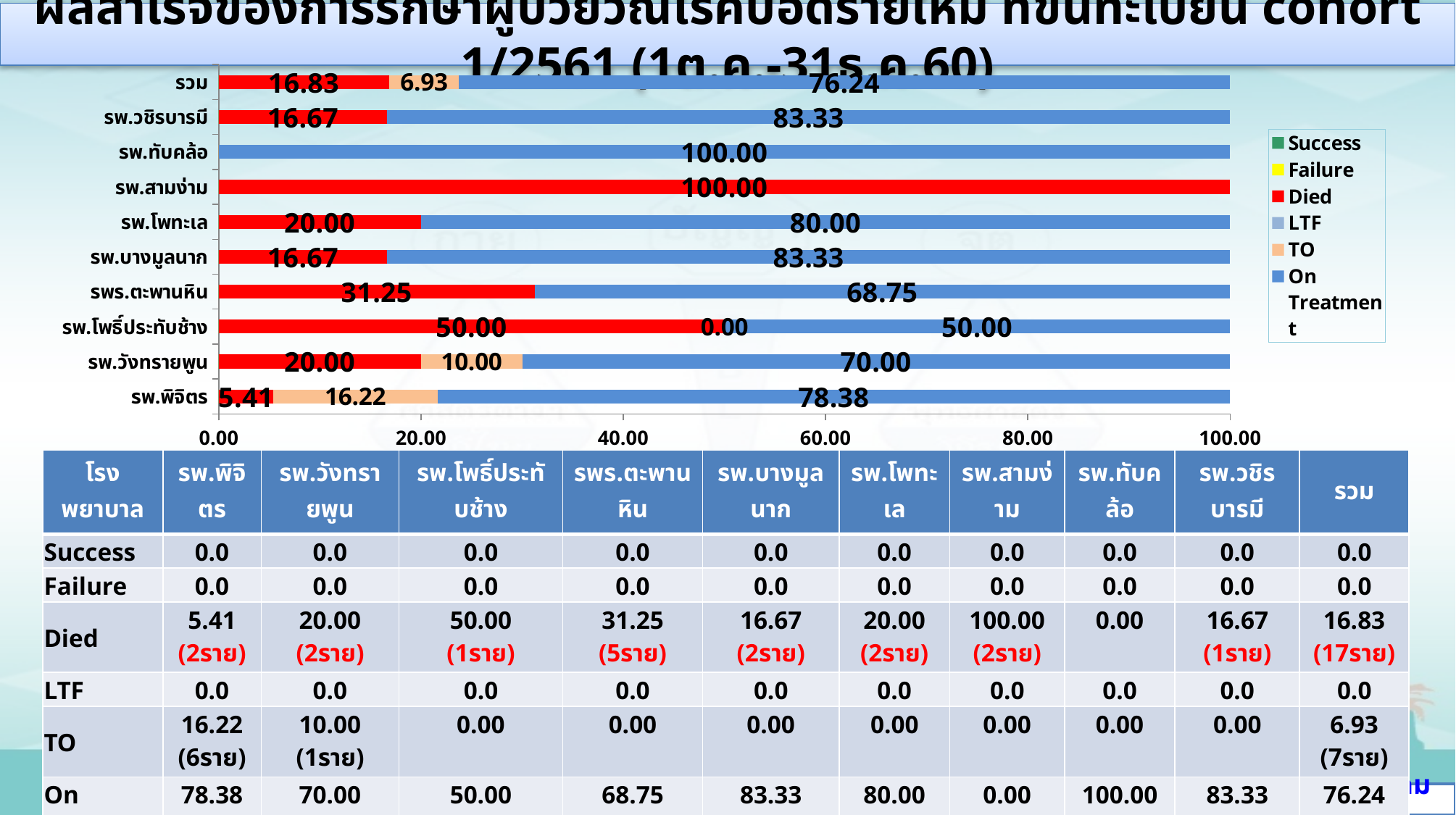
How many hospital categories (including รวม) are plotted on the chart? 10 What is the On Treatment value for รวม? 76.24 Which is larger, the Died value for รพ.โพธิ์ประทับช้าง or the Died value for รพ.โพทะเล? รพ.โพธิ์ประทับช้าง What kind of chart is shown on the slide? stacked bar chart What is the On Treatment value for รพ.วังทรายพูน? 70.00 Which legend entry is shown in red? Died Which hospital has the lowest Died value among those with a non-zero Died segment? รพ.พิจิตร What is the difference between the On Treatment values of รพ.วชิรบารมี and รพ.โพทะเล? 3.33 What is the Died value for รพร.ตะพานหิน? 31.25 How many series does the chart legend list? 6 Which hospital has the highest Died value? รพ.สามง่าม What is the TO value for รพ.พิจิตร? 16.22